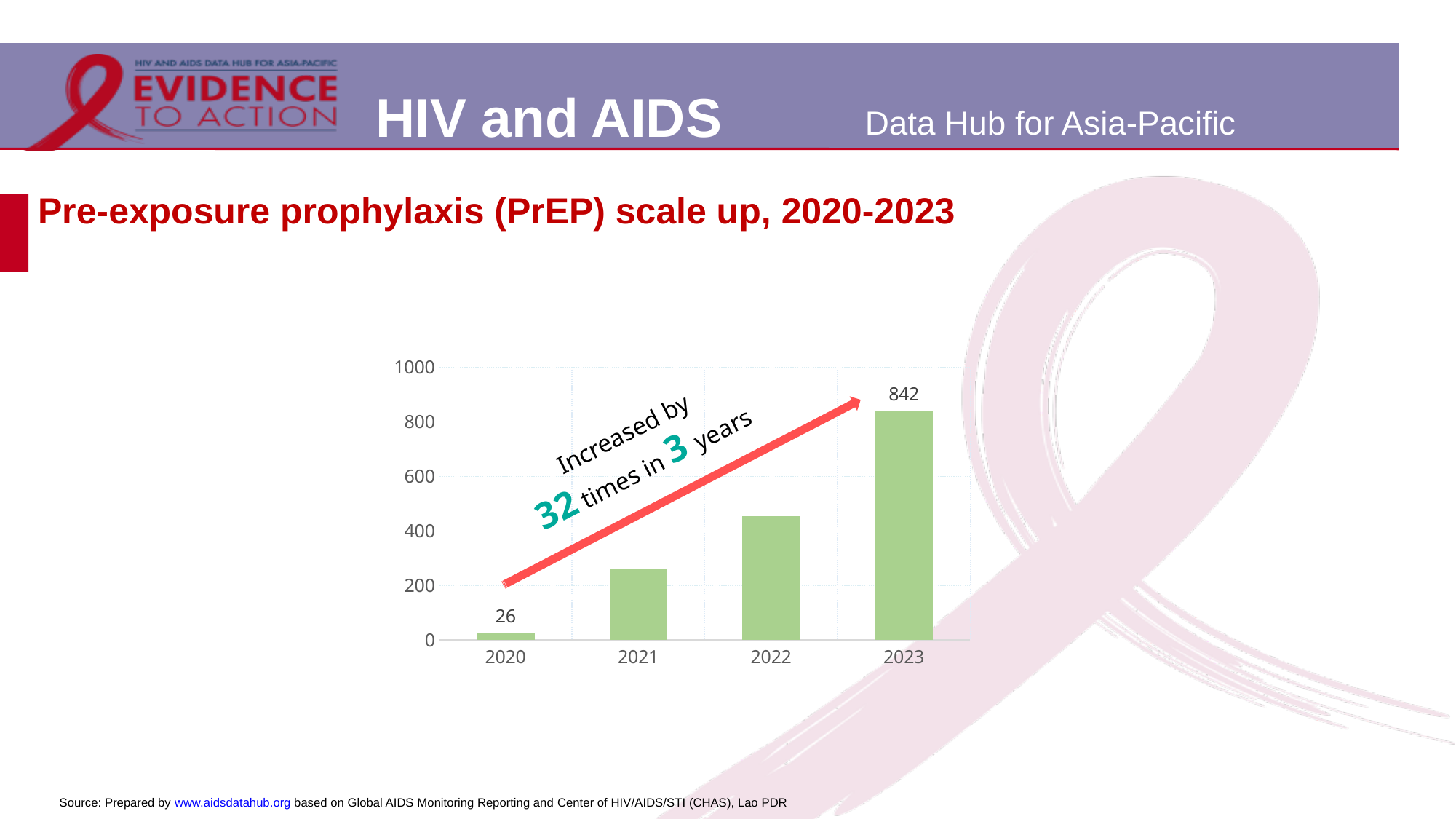
Is the value for 2022 greater or less than 400? greater Which year has the lowest value? 2020 How many years are shown on the x axis? 4 According to the annotation on the chart, by how many times did the value increase in 3 years? 32 times What kind of chart is shown on the slide? bar chart Which year has the highest value? 2023 What is the value for 2023? 842 Which is larger, the value for 2021 or the value for 2022? 2022 Is the value for 2021 greater or less than 400? less Do the values rise or fall from 2020 to 2023? rise What is the value for 2020? 26 What is the difference between the values for 2023 and 2020? 816